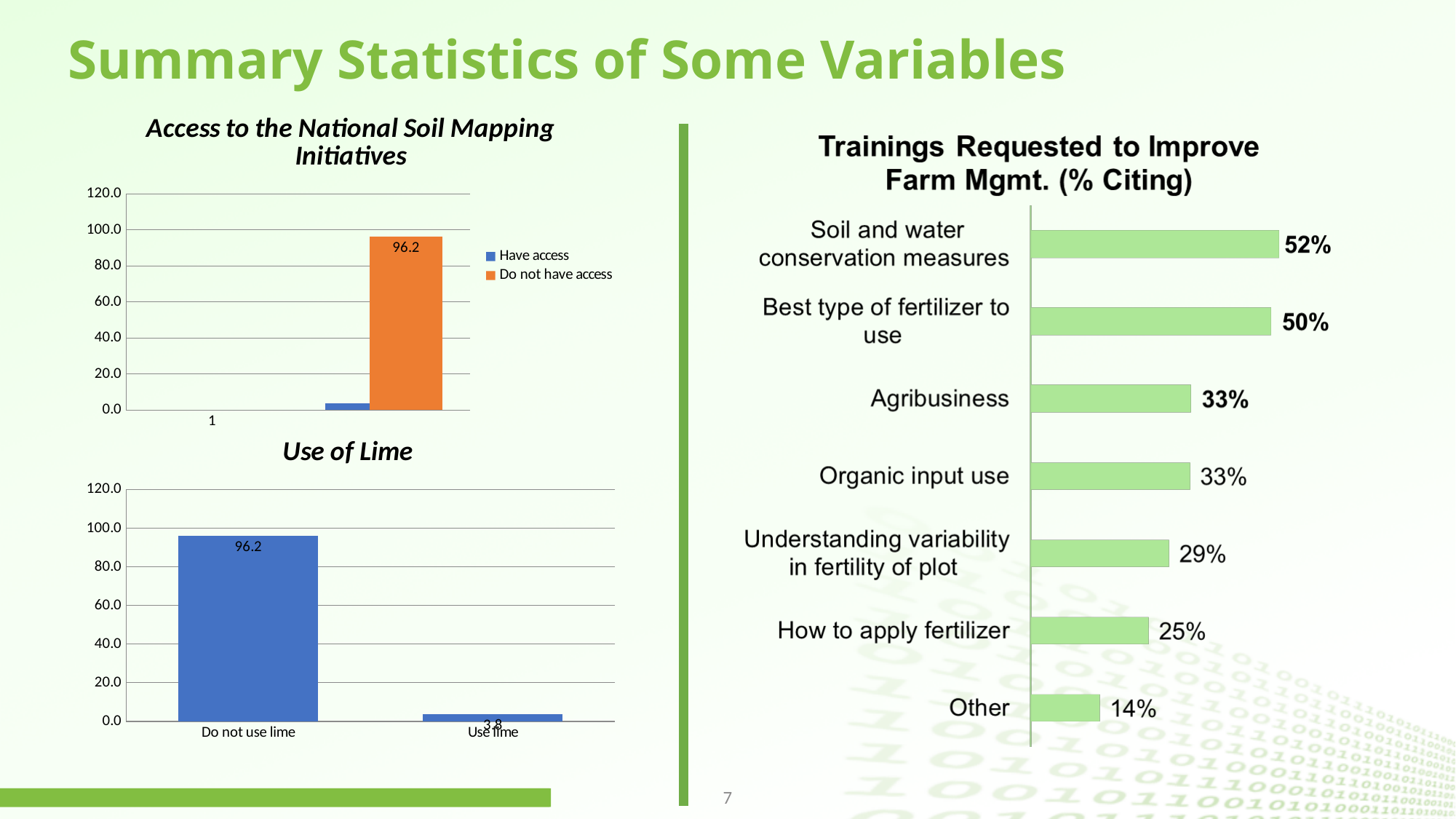
In the 'Trainings Requested to Improve Farm Mgmt. (% Citing)' chart, what percentage is shown for 'Understanding variability in fertility of plot'? 29% In the 'Trainings Requested to Improve Farm Mgmt. (% Citing)' chart, how many training categories are listed? 7 In the 'Use of Lime' chart, what is the difference between 'Do not use lime' and 'Use lime'? 92.4 In the 'Trainings Requested to Improve Farm Mgmt. (% Citing)' chart, which training has the lowest percentage citing? Other In the 'Use of Lime' chart, what is the value for 'Use lime'? 3.8 In the 'Access to the National Soil Mapping Initiatives' chart, what is the value for 'Do not have access'? 96.2 In the 'Trainings Requested to Improve Farm Mgmt. (% Citing)' chart, what is the difference between 'Best type of fertilizer to use' and 'How to apply fertilizer'? 25% In the 'Trainings Requested to Improve Farm Mgmt. (% Citing)' chart, which training has the highest percentage citing? Soil and water conservation measures In the 'Access to the National Soil Mapping Initiatives' chart, how many series does the legend list? 2 In the 'Use of Lime' chart, what is the value for 'Do not use lime'? 96.2 In the 'Access to the National Soil Mapping Initiatives' chart, is the value for 'Have access' greater or less than 20.0? less In the 'Trainings Requested to Improve Farm Mgmt. (% Citing)' chart, what percentage is shown for 'Soil and water conservation measures'? 52%